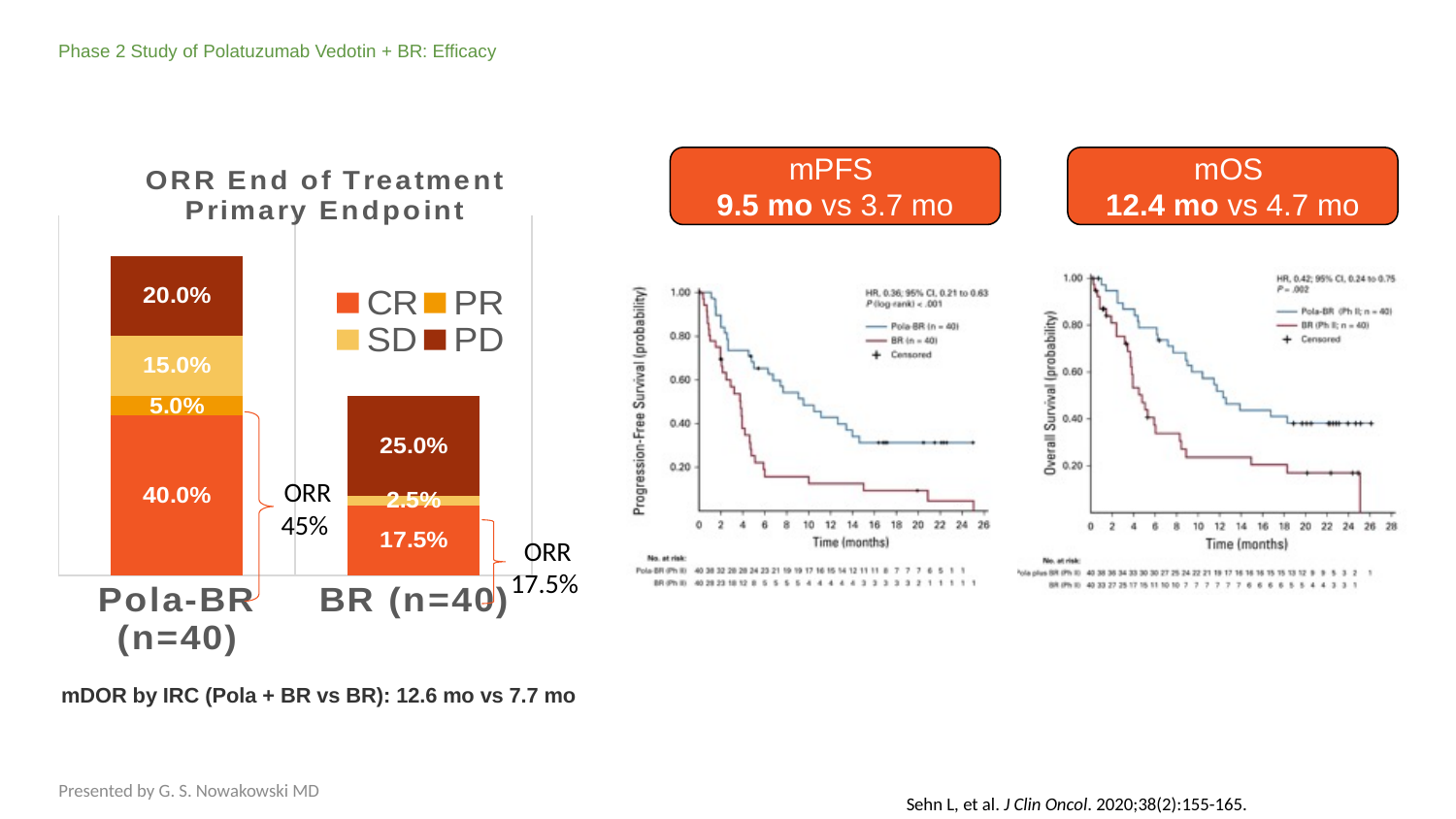
In the ORR End of Treatment Primary Endpoint chart, what is the SD value for Pola-BR (n=40)? 15.0% In the ORR End of Treatment Primary Endpoint chart, what is the PD value for BR (n=40)? 25.0% In the ORR End of Treatment Primary Endpoint chart, what is the ORR shown for Pola-BR (n=40)? 45% In the mOS chart on the right, what is the median OS for Pola-BR versus BR? 12.4 mo vs 4.7 mo In the ORR End of Treatment Primary Endpoint chart, what is the ORR shown for BR (n=40)? 17.5% In the ORR End of Treatment Primary Endpoint chart, what is the difference between the CR values for Pola-BR (n=40) and BR (n=40)? 22.5% What kind of chart is the ORR End of Treatment Primary Endpoint chart? Stacked bar chart In the ORR End of Treatment Primary Endpoint chart, which arm has the larger PD value, Pola-BR (n=40) or BR (n=40)? BR (n=40) In the ORR End of Treatment Primary Endpoint chart, what is the CR value for Pola-BR (n=40)? 40.0% How many series does the legend of the ORR End of Treatment Primary Endpoint chart list? 4 In the mPFS chart on the right, what is the median PFS for Pola-BR versus BR? 9.5 mo vs 3.7 mo